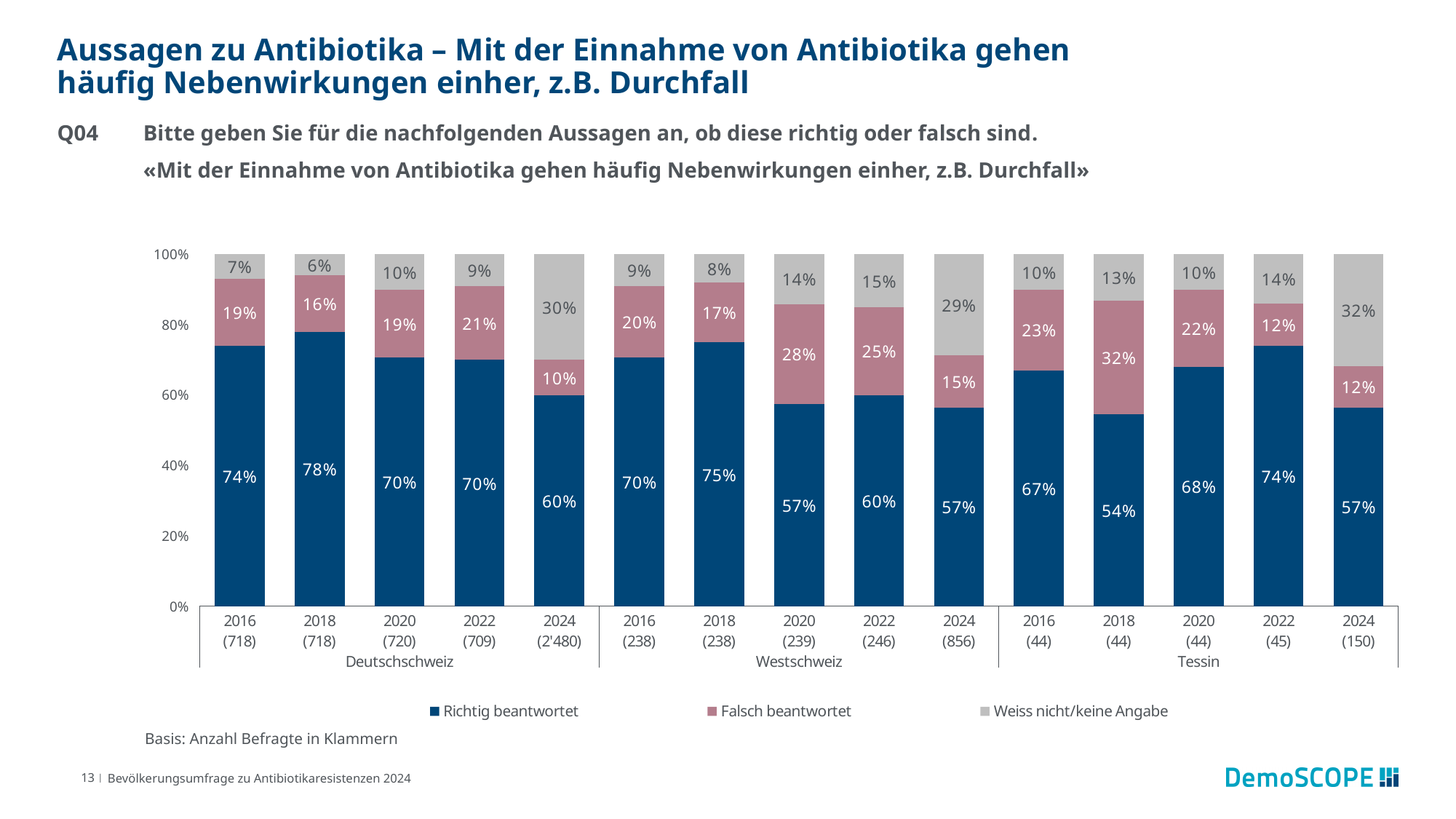
What are the three legend entries of the chart? Richtig beantwortet, Falsch beantwortet, Weiss nicht/keine Angabe Does the 'Richtig beantwortet' share in Deutschschweiz rise or fall overall from 2016 to 2024? Falls (74% to 60%) What type of chart is shown on the slide? Stacked bar chart What percentage answered 'Richtig beantwortet' in Deutschschweiz in 2024? 60% Which bar has the highest 'Richtig beantwortet' value across all regions and years? Deutschschweiz 2018 (78%) In Tessin, which year has the lowest 'Richtig beantwortet' value? 2018 (54%) Which has the larger 'Falsch beantwortet' share in 2020: Westschweiz or Tessin? Westschweiz (28% vs 22%) What is the 'Falsch beantwortet' value for Tessin in 2018? 32% By how many percentage points did 'Richtig beantwortet' in Deutschschweiz fall from 2018 to 2024? 18 percentage points How many series does the legend list? 3 How many stacked bars are shown in the chart? 15 What is the 'Weiss nicht/keine Angabe' share for Tessin in 2024? 32%